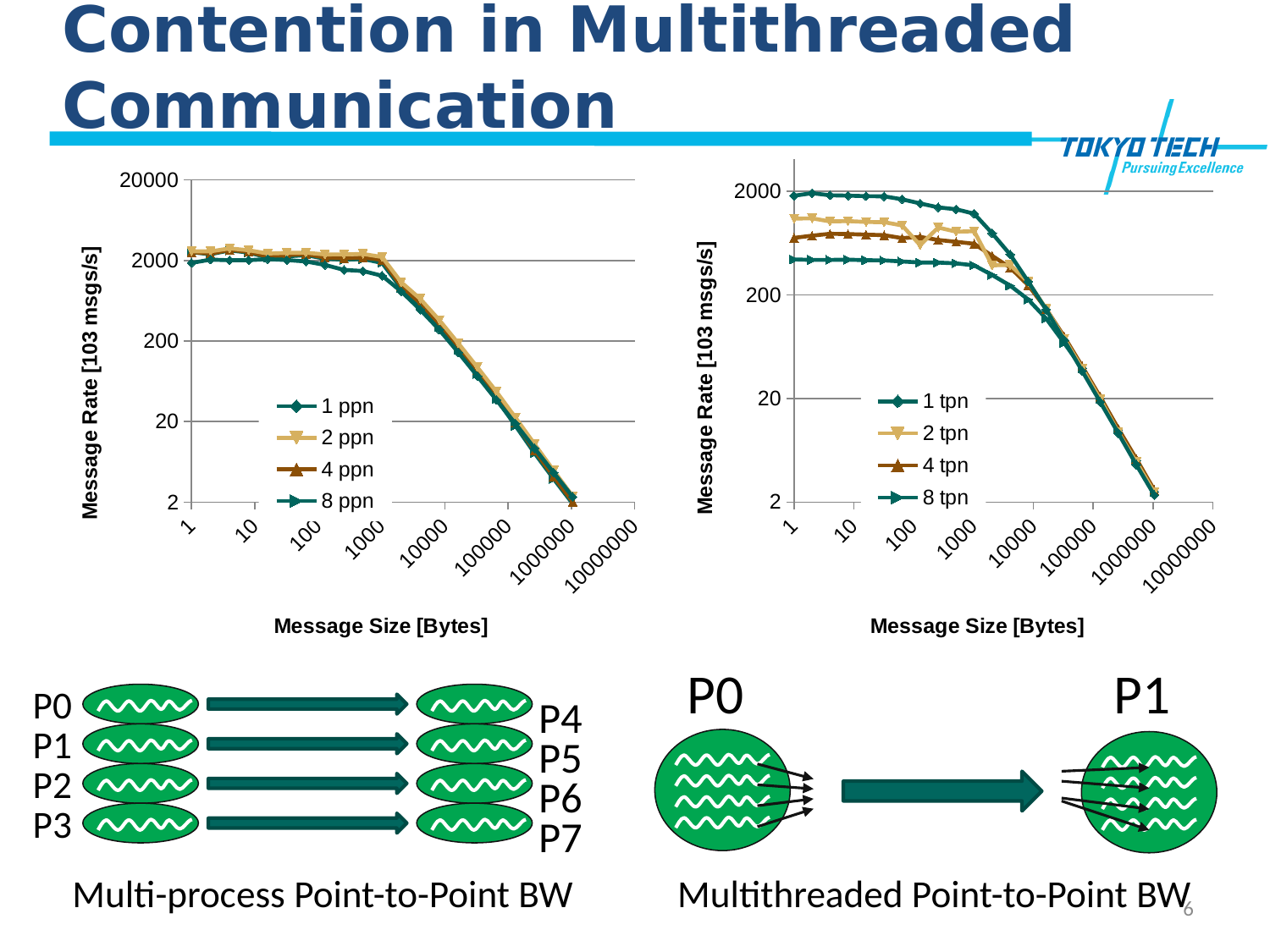
How many series does the legend of the right chart (Multithreaded Point-to-Point BW) list? 4 In the left chart (Multi-process Point-to-Point BW), is the value for 2 ppn at a message size of 10000 bytes greater or less than 200? greater In the right chart (Multithreaded Point-to-Point BW), which series has the highest message rate at a message size of 1 byte? 1 tpn In the right chart (Multithreaded Point-to-Point BW), at a message size of 1 byte, which is larger: 2 tpn or 4 tpn? 2 tpn In the right chart (Multithreaded Point-to-Point BW), do the message rates rise or fall as message size increases along the x axis? fall In the left chart (Multi-process Point-to-Point BW), is the value for 1 ppn at a message size of 100000 bytes greater or less than 200? less What is the x-axis title of the right chart (Multithreaded Point-to-Point BW)? Message Size [Bytes] How many tick labels are shown on the x axis of the left chart (Multi-process Point-to-Point BW)? 8 What kind of chart is the left chart (Multi-process Point-to-Point BW)? line chart How many series does the legend of the left chart (Multi-process Point-to-Point BW) list? 4 In the right chart (Multithreaded Point-to-Point BW), is the value for 8 tpn at a message size of 1 byte greater or less than 200? greater In the right chart (Multithreaded Point-to-Point BW), which series has the lowest message rate at a message size of 1 byte? 8 tpn